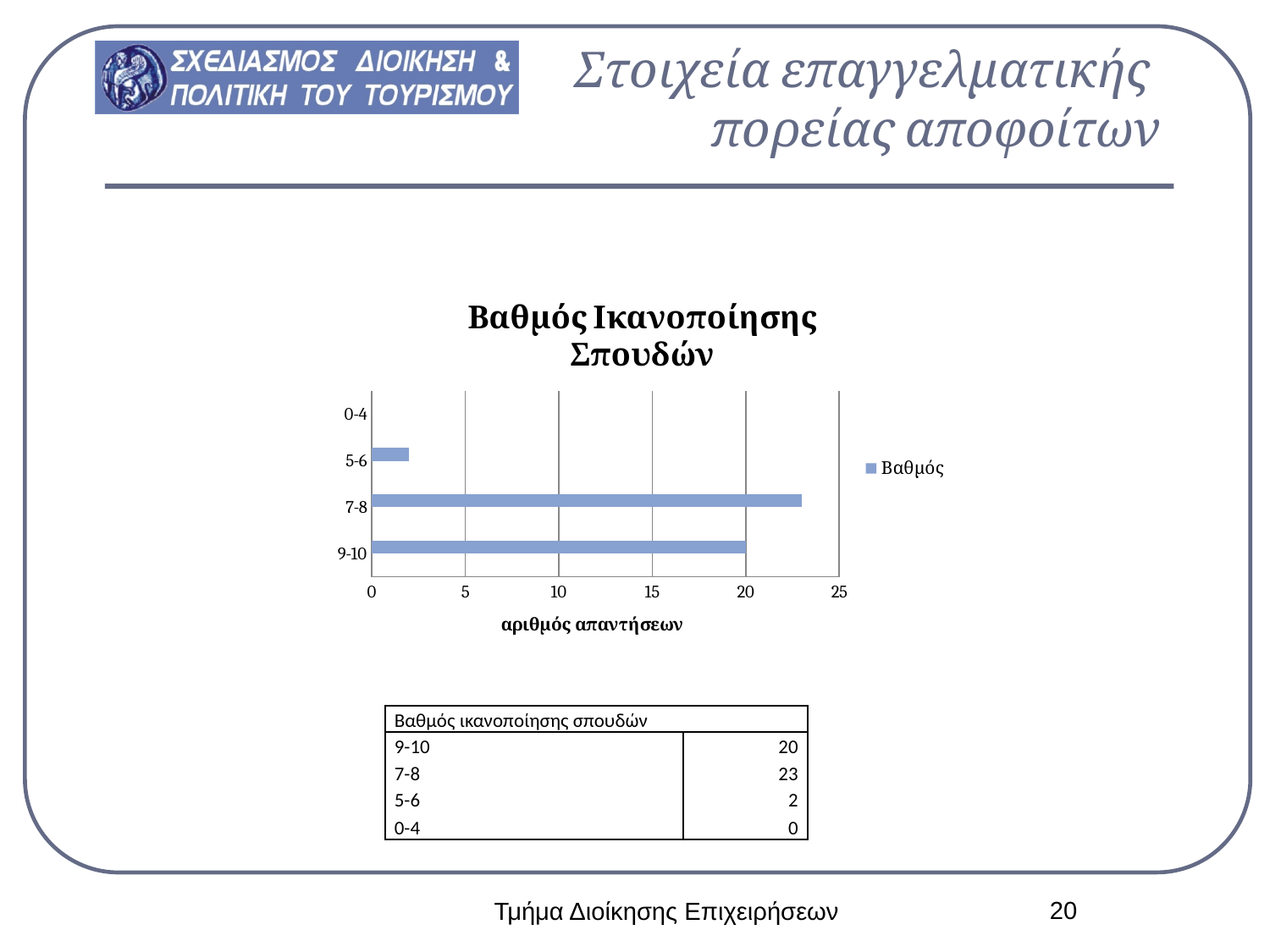
What is the number of responses for the 0-4 category? 0 What is the difference in responses between the 7-8 and 9-10 categories? 3 What type of chart is shown on the slide? bar chart Which category has the lowest number of responses? 0-4 Is the value for the 7-8 category greater or less than 20? greater What is the number of responses for the 5-6 category? 2 What is the number of responses for the 7-8 category? 23 How many series does the chart legend list? 1 Which category has the highest number of responses? 7-8 What is the title of the chart? Βαθμός Ικανοποίησης Σπουδών What is the number of responses for the 9-10 category? 20 How many categories are shown on the chart's vertical axis? 4